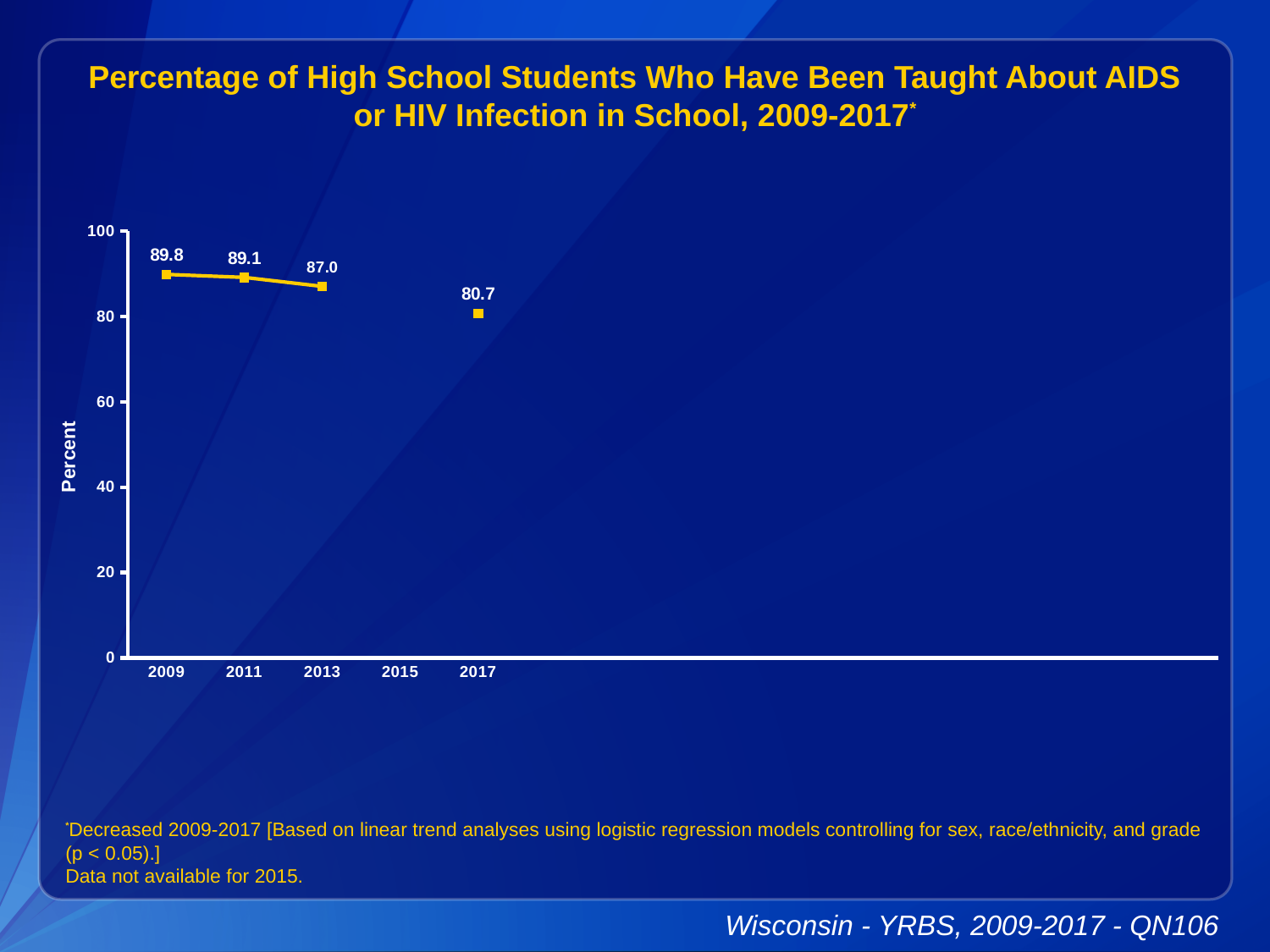
Is the value for 2017 greater or less than 80? greater What is the difference between the values for 2009 and 2017? 9.1 What is the value for 2017? 80.7 What kind of chart is shown? line chart What is the value for 2011? 89.1 How many years have a plotted data point? 4 Which is larger, the value for 2011 or the value for 2013? 2011 Do the values rise or fall from 2009 to 2017? fall What is the value for 2013? 87.0 What is the value for 2009? 89.8 Which year has the lowest plotted value? 2017 Which year has the highest value? 2009